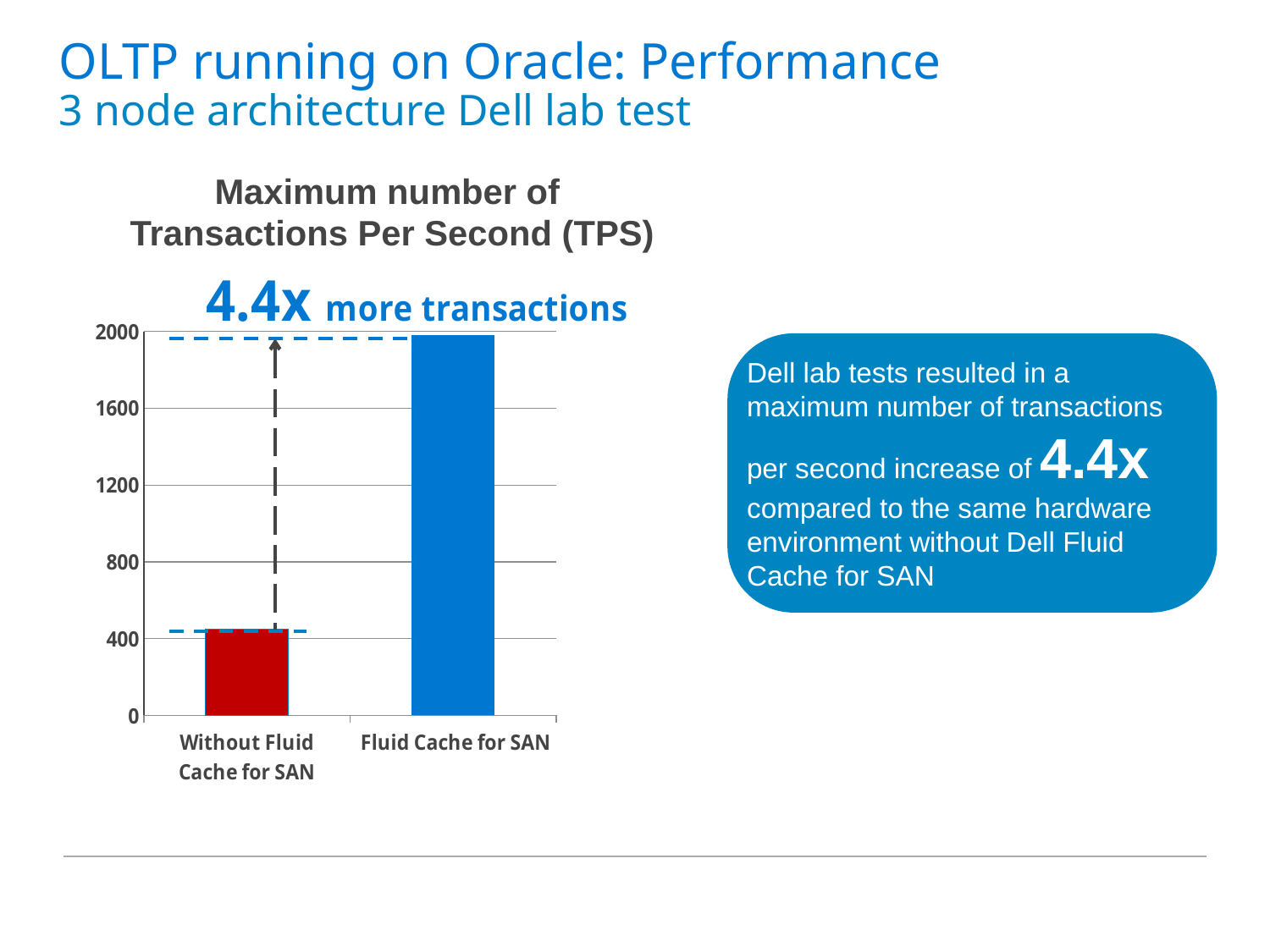
Is the value for Without Fluid Cache for SAN greater or less than 800? less What is the title of the chart? Maximum number of Transactions Per Second (TPS) What kind of chart is shown on the slide? bar chart Is the value for Fluid Cache for SAN greater or less than 1600? greater Is the value for Fluid Cache for SAN greater or less than 1200? greater How many categories are plotted in the chart? 2 Which is larger: the value for Without Fluid Cache for SAN or the value for Fluid Cache for SAN? Fluid Cache for SAN Which category has the highest value in the chart? Fluid Cache for SAN According to the annotation on the chart, how many times more transactions does Fluid Cache for SAN deliver? 4.4x Which category has the lowest value in the chart? Without Fluid Cache for SAN What is the highest value shown on the chart's vertical axis? 2000